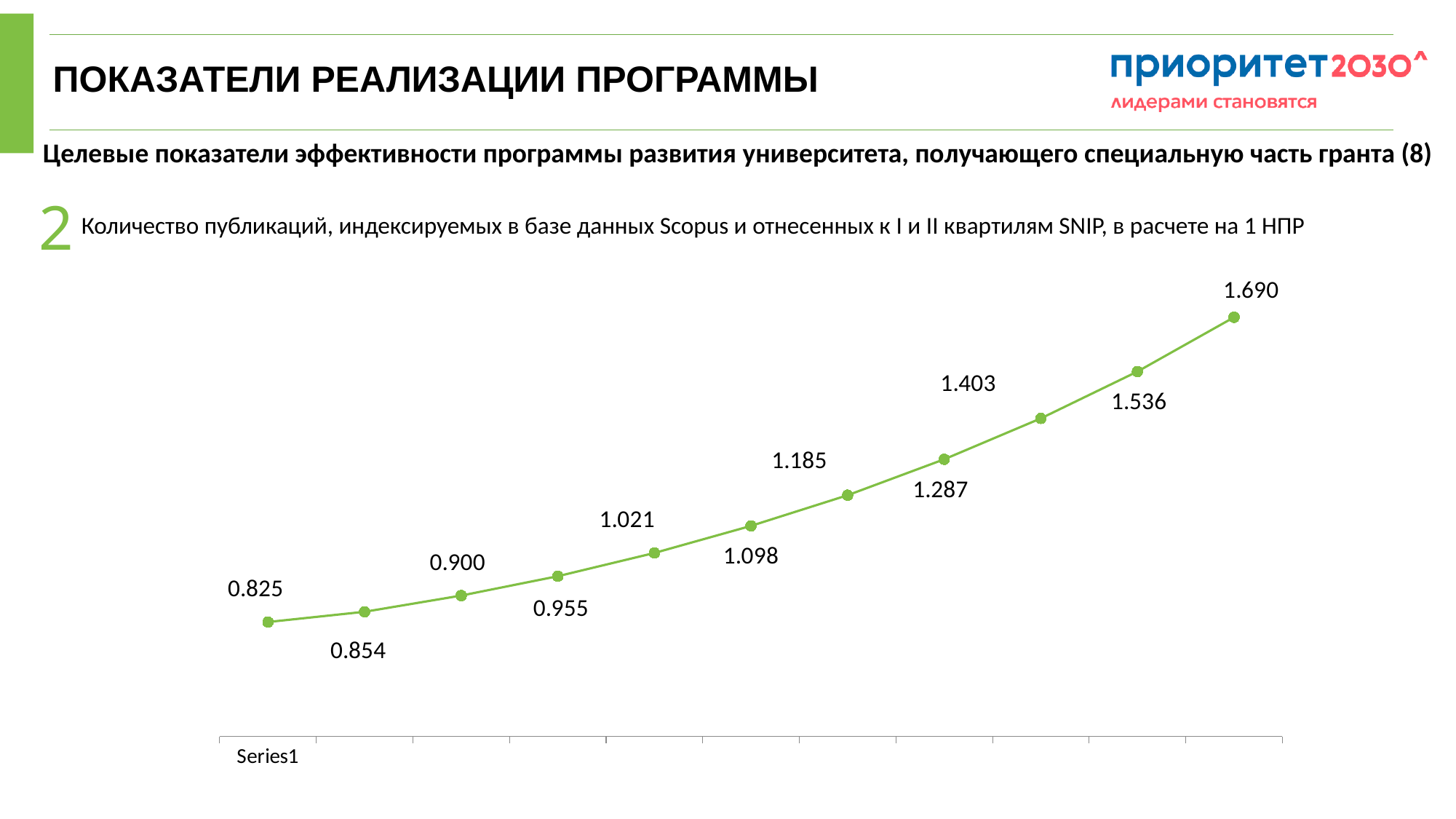
What is the value of the last (rightmost) point on the line? 1.690 How many data points are plotted on the line? 11 Which is larger, the value of the second point (0.854) or the third point (0.900)? 0.900 What is the difference between the last value (1.690) and the first value (0.825)? 0.865 What kind of chart is shown on the slide? line chart What is the highest value shown on the chart? 1.690 What is the lowest value shown on the chart? 0.825 What label appears under the first point on the x axis? Series1 What is the value of the fifth point from the left on the line? 1.021 What is the value of the first (leftmost) point on the line? 0.825 What is the difference between the values 1.403 and 1.287 on the chart? 0.116 Do the values rise or fall from left to right along the x axis? rise